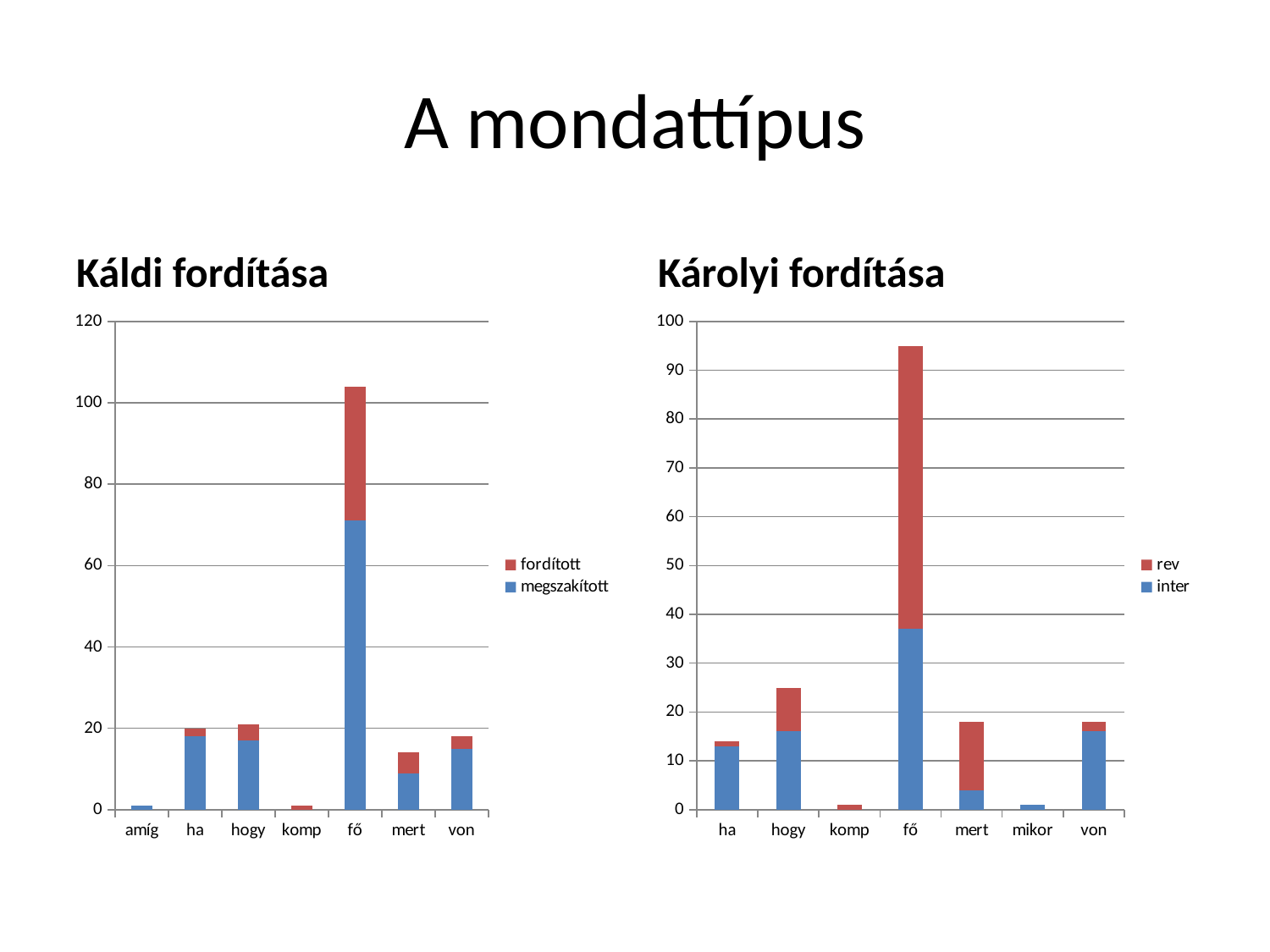
In the 'Káldi fordítása' chart, which category has the highest total bar? fő In the 'Károlyi fordítása' chart, which has the larger total bar, hogy or ha? hogy In the 'Káldi fordítása' chart, is the total value for fő greater or less than 100? greater How many categories are shown on the x axis of the 'Káldi fordítása' chart? 7 In the 'Károlyi fordítása' chart, which has the larger total bar, mert or mikor? mert In the 'Káldi fordítása' chart, is the total value for ha greater or less than 40? less What are the two legend entries of the 'Károlyi fordítása' chart? rev and inter How many series does the legend of the 'Káldi fordítása' chart list? 2 In the 'Károlyi fordítása' chart, is the total value for fő greater or less than 90? greater In the 'Károlyi fordítása' chart, which category has the highest total bar? fő What kind of chart is the 'Káldi fordítása' chart? stacked bar chart How many categories are shown on the x axis of the 'Károlyi fordítása' chart? 7